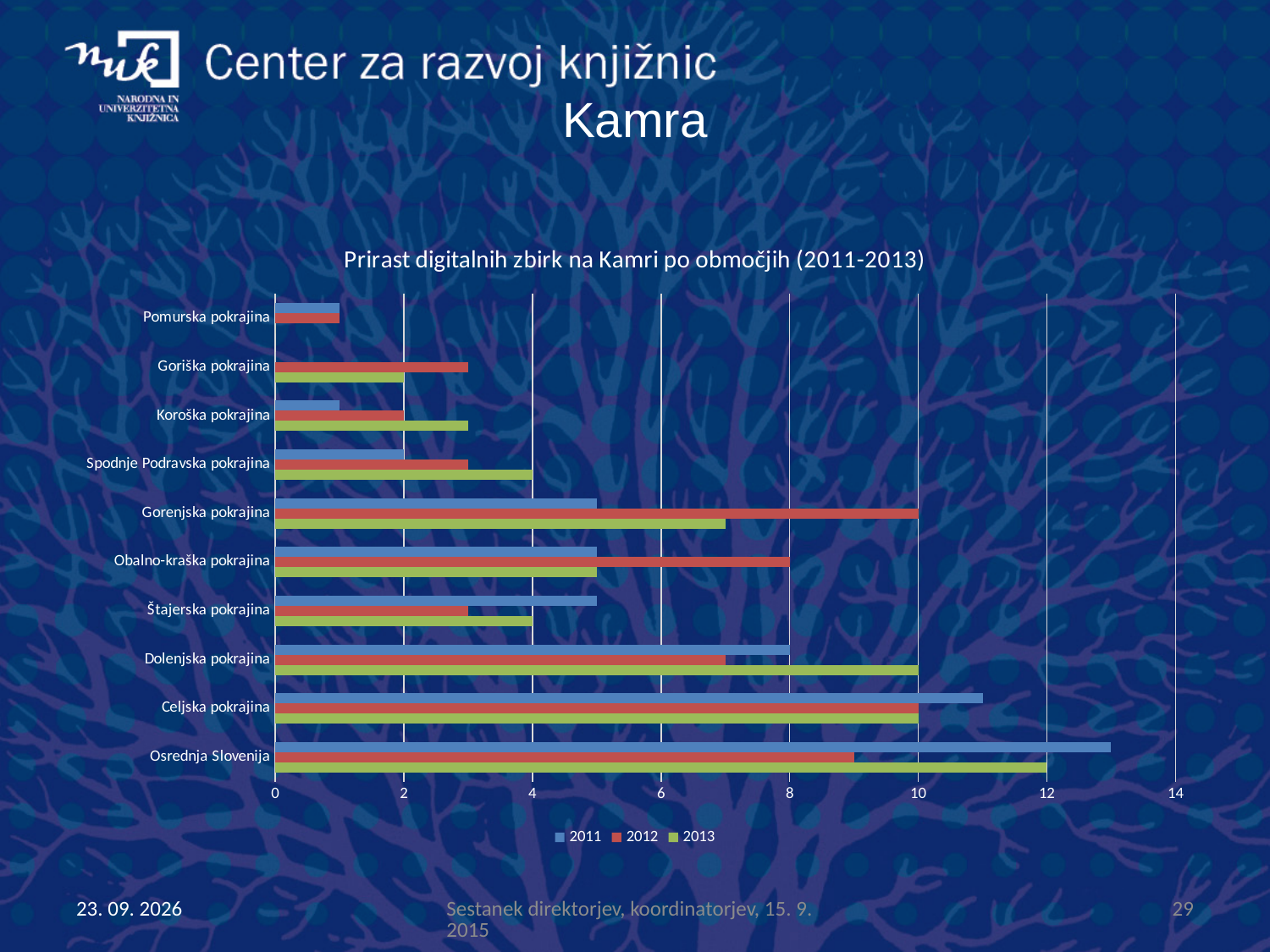
How many regions (categories) are shown on the chart? 10 Which region has the highest 2011 value? Osrednja Slovenija What is the 2013 value for Osrednja Slovenija? 12 What is the 2012 value for Obalno-kraška pokrajina? 8 What kind of chart is shown on the slide? bar chart Is the 2011 value for Osrednja Slovenija greater or less than 12? greater What is the title of the chart? Prirast digitalnih zbirk na Kamri po območjih (2011-2013) Which is larger for Gorenjska pokrajina, the 2012 value or the 2013 value? 2012 What is the 2011 value for Dolenjska pokrajina? 8 What is the 2012 value for Gorenjska pokrajina? 10 How many series does the legend list? 3 Is the 2011 value for Celjska pokrajina greater or less than 10? greater